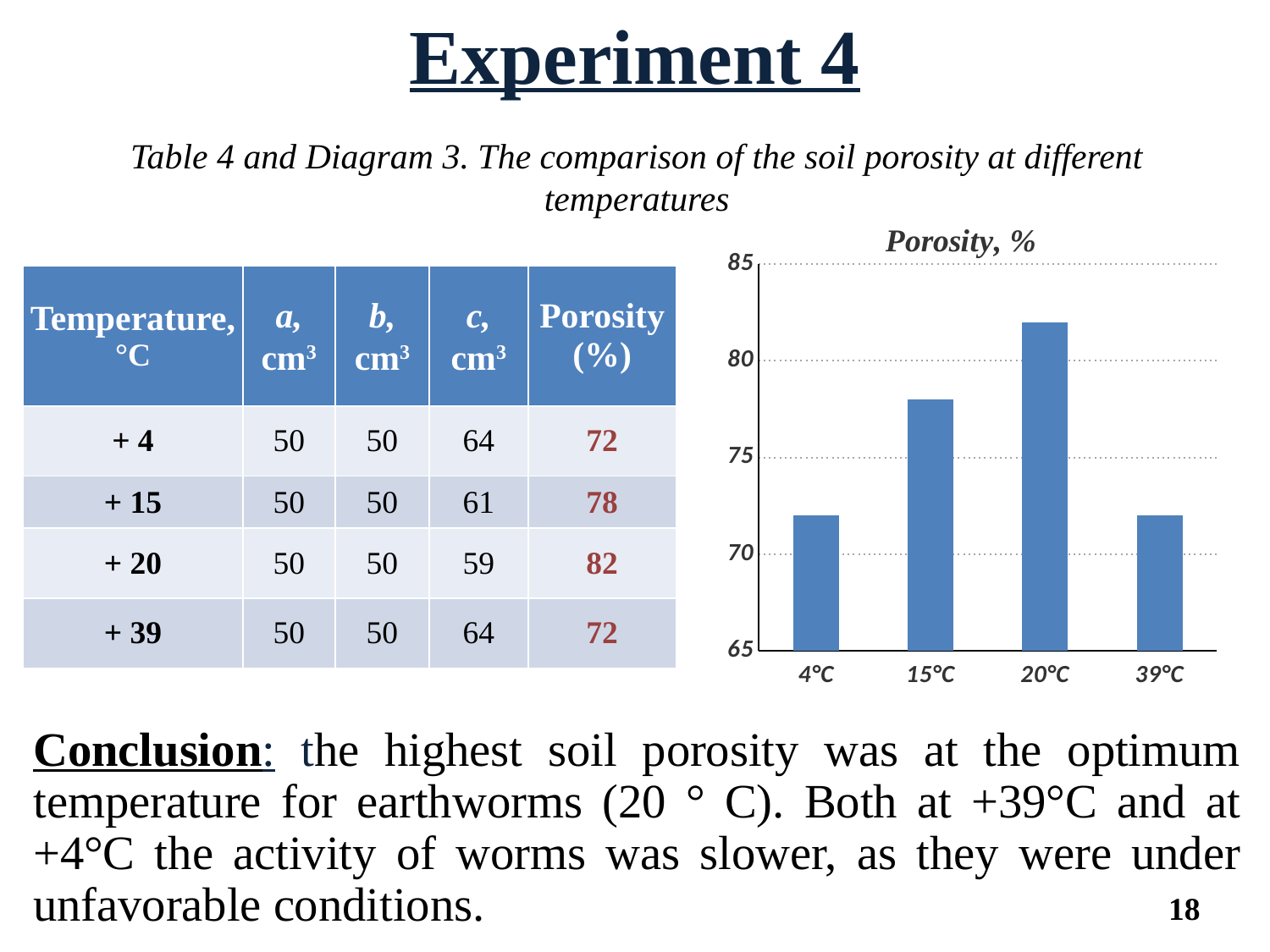
Is the porosity value for 20°C greater or less than 80? greater How many temperature categories are plotted in the chart? 4 Which has the larger porosity, 4°C or 15°C? 15°C Is the porosity value for 39°C greater or less than 75? less Do the porosity values rise or fall from 20°C to 39°C? fall Is the porosity value for 4°C greater or less than 75? less Which has the larger porosity, 15°C or 20°C? 20°C What kind of chart is shown on the slide? bar chart Which temperature has the highest porosity in the chart? 20°C What is the title of the chart? Porosity, % What is the porosity (%) at 20°C? 82